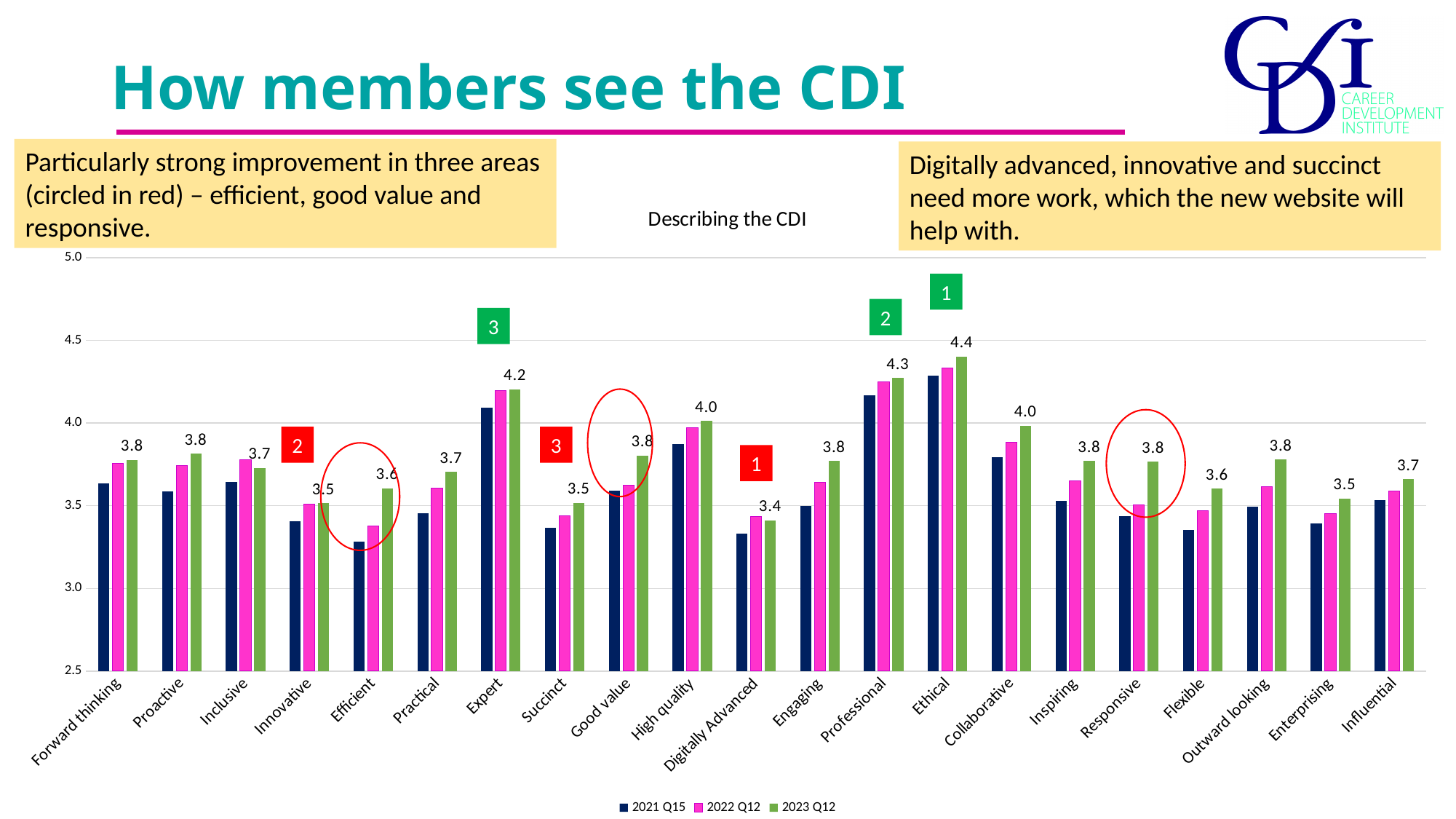
Is the 2021 Q15 value for Ethical greater or less than 4.0? greater Is the 2021 Q15 value for Efficient greater or less than 3.5? less What is the 2023 Q12 value for Digitally Advanced? 3.4 What is the difference between the 2023 Q12 values for Ethical and Digitally Advanced? 1.0 What is the 2023 Q12 value for Ethical? 4.4 Which category has the highest 2023 Q12 value? Ethical What is the 2023 Q12 value for Expert? 4.2 What kind of chart is shown on the slide? Bar chart How many categories are shown on the x axis? 21 Which has the larger 2023 Q12 value, Professional or Collaborative? Professional Which category has the lowest 2023 Q12 value? Digitally Advanced How many series does the legend list? 3